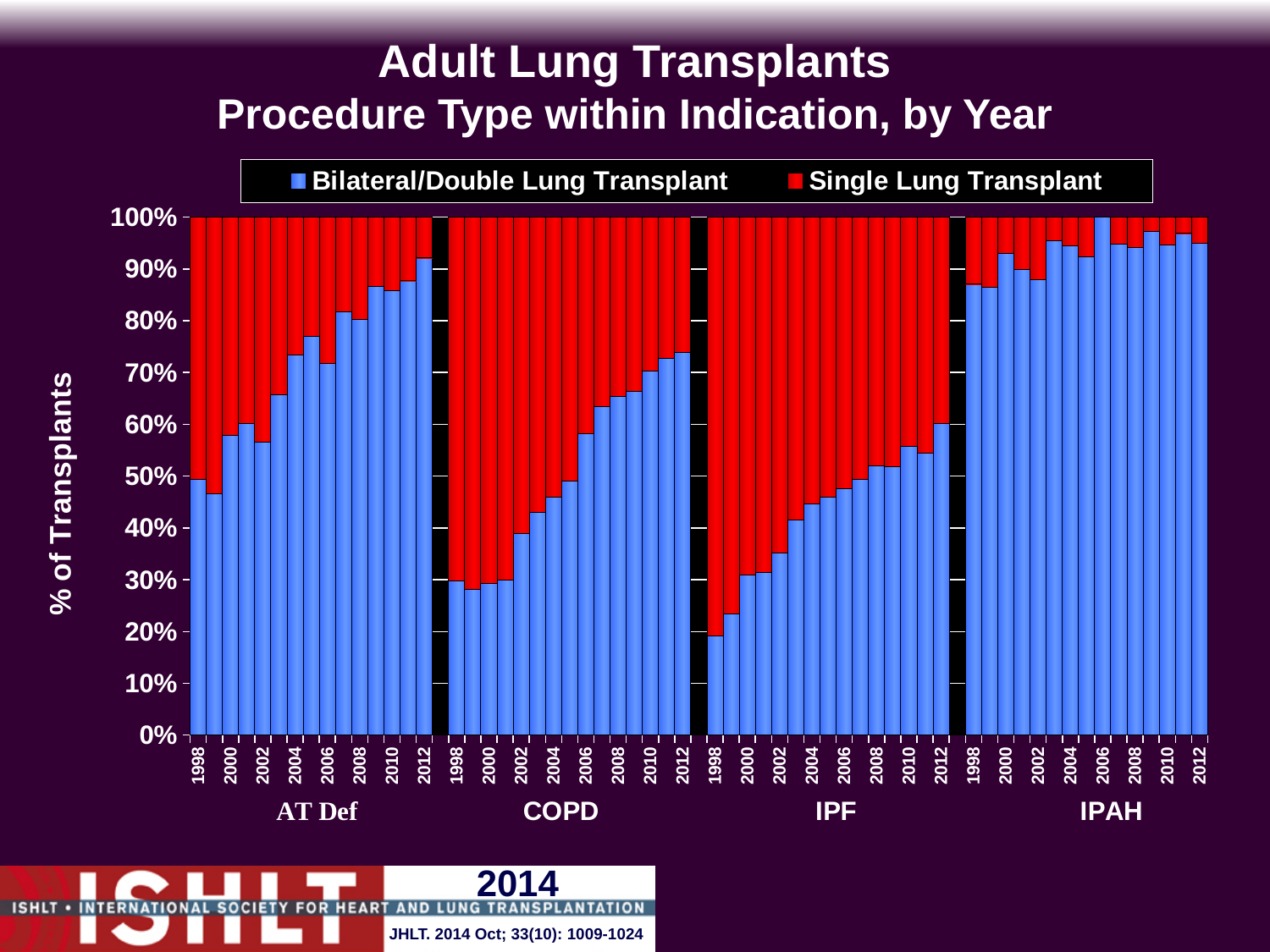
In 1998, which indication group has the highest Bilateral/Double Lung Transplant share? IPAH Is the Bilateral/Double Lung Transplant share for AT Def in 2012 greater or less than 80%? greater Which series is shown in red in the legend? Single Lung Transplant In 1998, which indication group has the lowest Bilateral/Double Lung Transplant share? IPF Within the COPD group, does the Bilateral/Double Lung Transplant share rise or fall from 1998 to 2012? rise What kind of chart is shown on the slide? stacked bar chart Is the Bilateral/Double Lung Transplant share for IPF in 1998 greater or less than 30%? less How many indication groups are shown along the x axis? 4 How many series does the legend list? 2 Within the IPF group, does the Single Lung Transplant share rise or fall from 1998 to 2012? fall How many yearly bars are shown for the COPD group? 15 What is the label of the vertical axis? % of Transplants